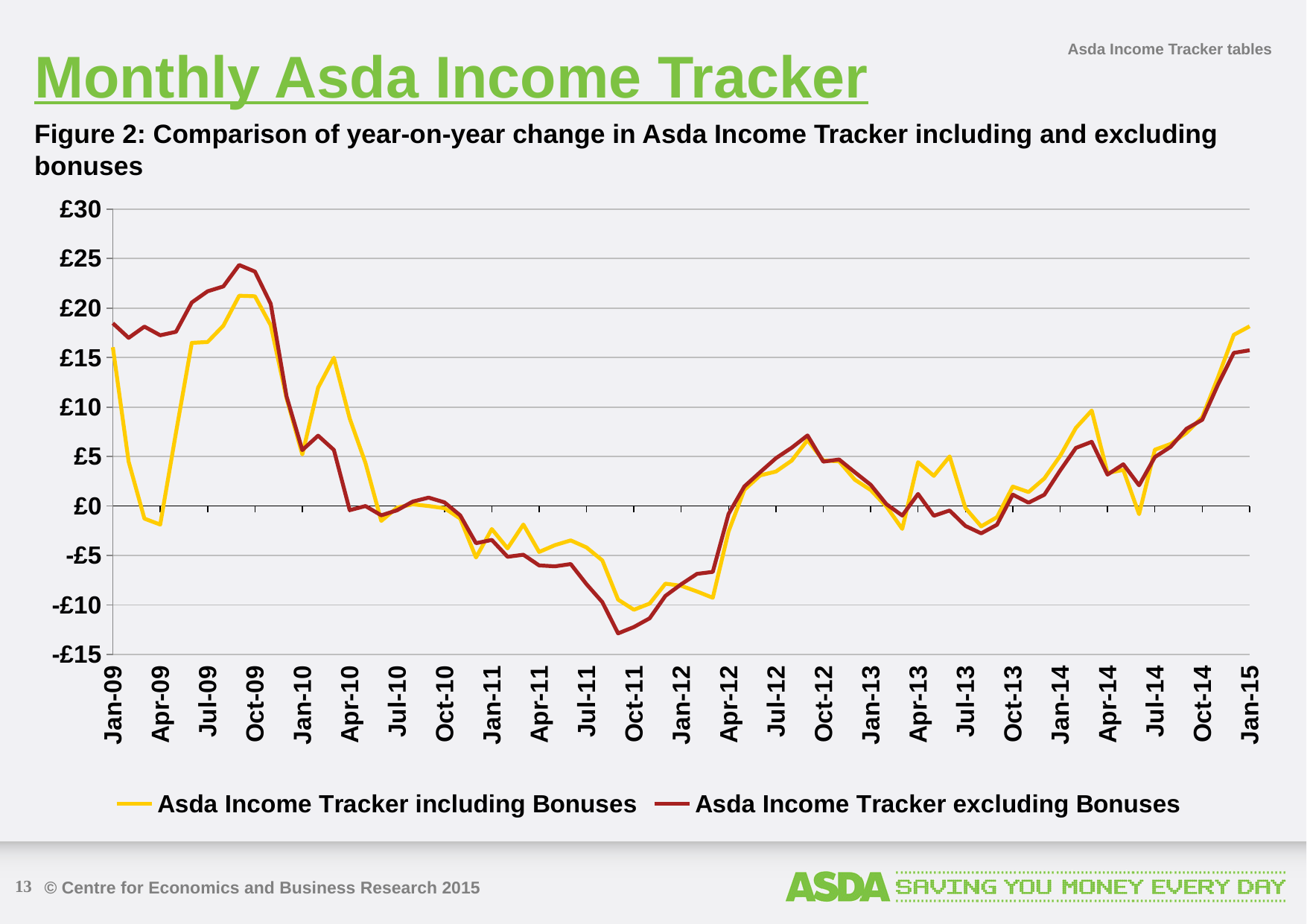
How many series does the legend list? 2 What kind of chart is shown on the slide? Line chart Is the value for Asda Income Tracker excluding Bonuses at Oct-11 greater or less than -£10? less Is the value for Asda Income Tracker including Bonuses at Jan-15 greater or less than £15? greater Around which x-axis label does the Asda Income Tracker excluding Bonuses line reach its lowest point? Oct-11 Is the value for Asda Income Tracker excluding Bonuses at Oct-09 greater or less than £20? greater At Apr-10, which series has the higher value: including Bonuses or excluding Bonuses? Asda Income Tracker including Bonuses Around which x-axis label does the Asda Income Tracker excluding Bonuses line reach its highest point? Oct-09 Which colour is used for the Asda Income Tracker excluding Bonuses line? Dark red What are the two series named in the legend? Asda Income Tracker including Bonuses; Asda Income Tracker excluding Bonuses How many date labels are shown on the x axis? 25